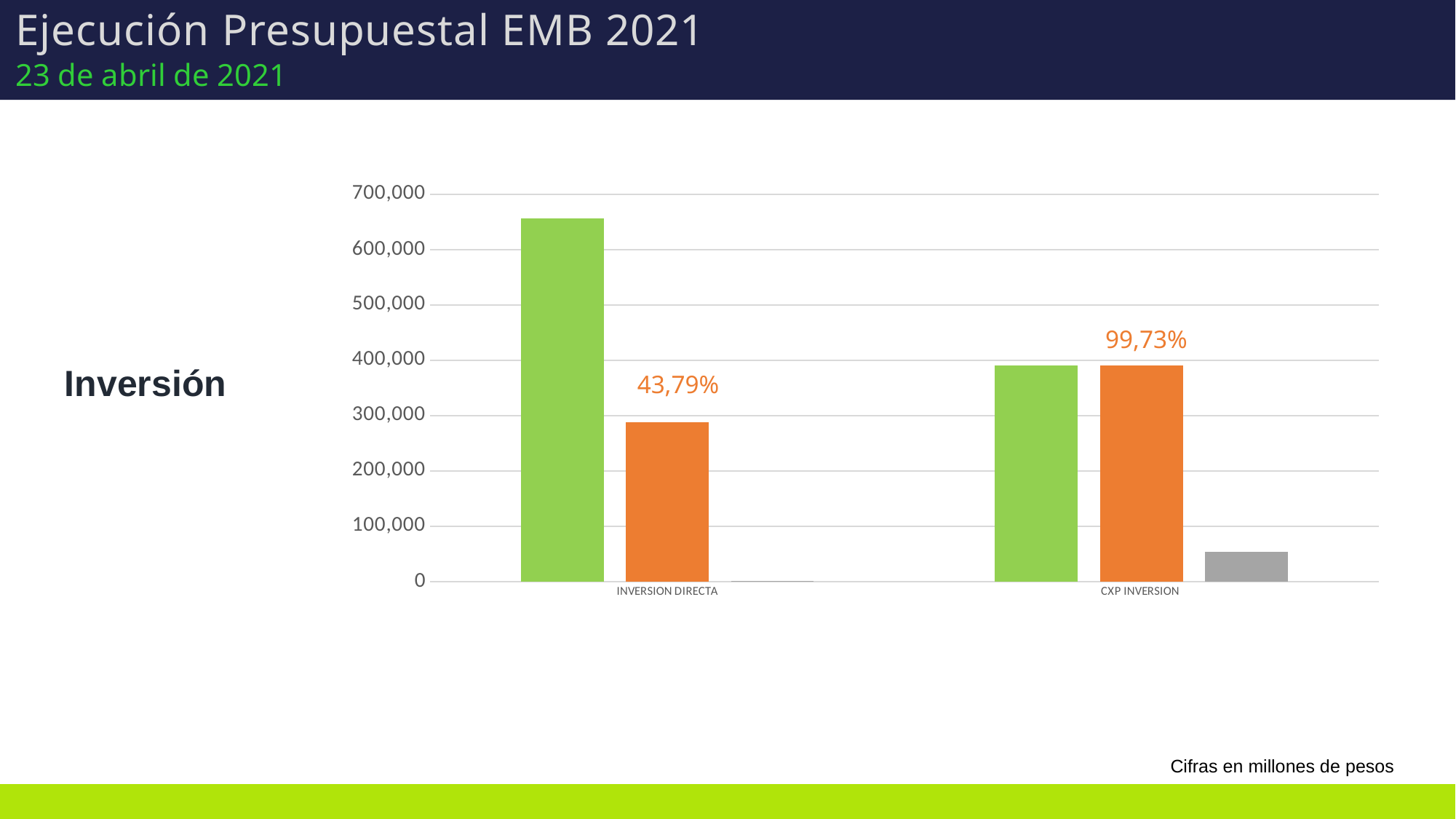
According to the note on the slide, in what units are the chart figures expressed? millones de pesos What is the highest tick value shown on the vertical axis of the chart? 700,000 Which category has the taller green bar, INVERSION DIRECTA or CXP INVERSION? INVERSION DIRECTA What kind of chart is shown on the slide? bar chart What percentage label is shown above the INVERSION DIRECTA group? 43,79% Is the value of the green bar for INVERSION DIRECTA greater or less than 600,000? greater Is the value of the gray bar for CXP INVERSION greater or less than 100,000? less What percentage label is shown above the CXP INVERSION group? 99,73% How many categories are shown on the x axis of the chart? 2 Is the value of the orange bar for INVERSION DIRECTA greater or less than 200,000? greater Which category has the higher percentage label, INVERSION DIRECTA or CXP INVERSION? CXP INVERSION